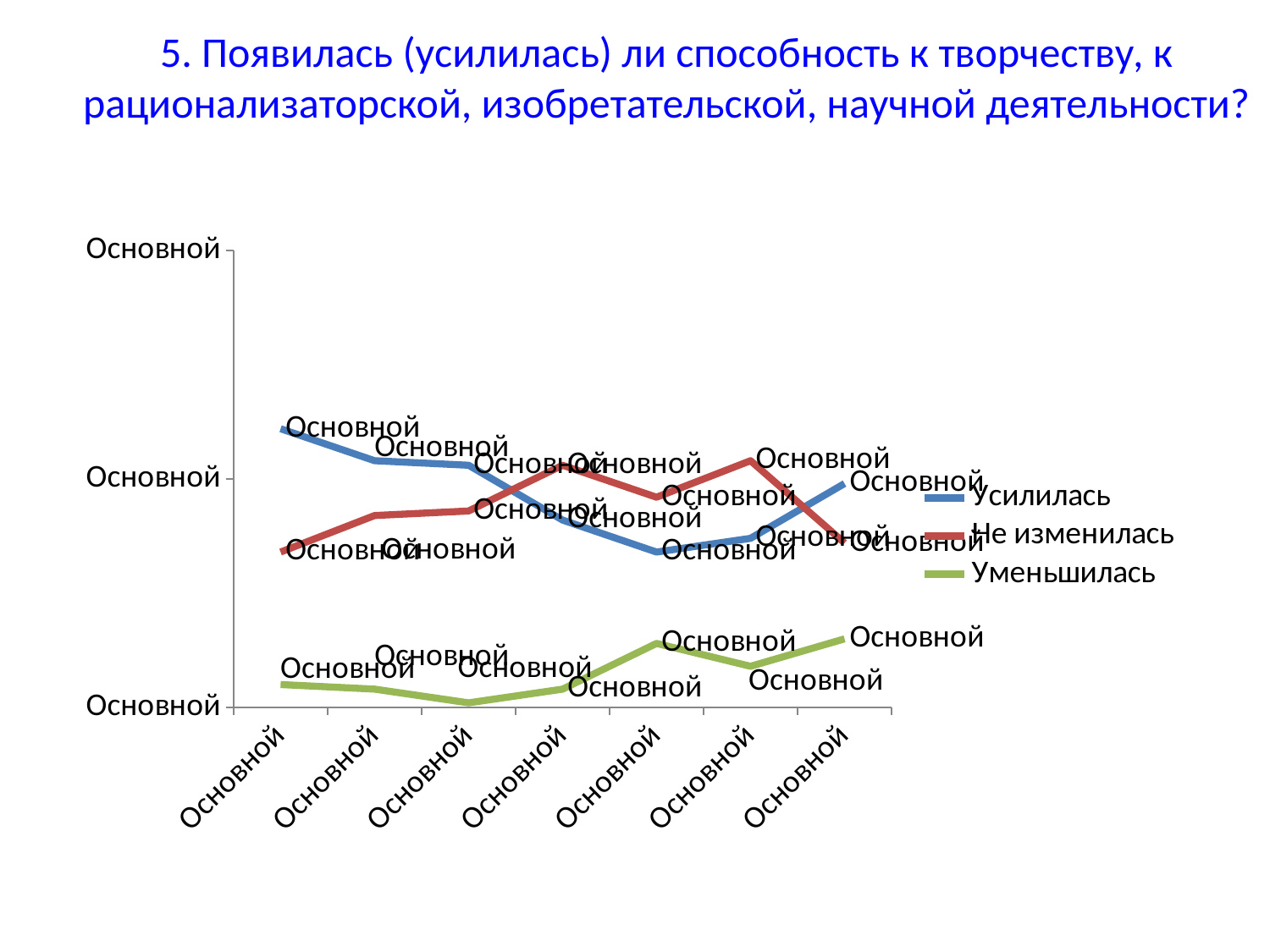
What are the three series named in the legend? Усилилась, Не изменилась, Уменьшилась How many series does the legend list? 3 Does the line for Уменьшилась rise or fall overall from left to right? rise At the leftmost point, which series is higher: Не изменилась or Уменьшилась? Не изменилась Which series reaches the highest point anywhere on the chart? Усилилась At the rightmost point, which series is higher: Усилилась or Уменьшилась? Усилилась Which series has the lowest values across the whole chart? Уменьшилась At the leftmost point, which series is higher: Усилилась or Не изменилась? Усилилась What kind of chart is shown on the slide? line chart Does the line for Усилилась rise or fall over its first four points? fall How many data points does each line have? 7 What colour is the line for the series Усилилась? blue